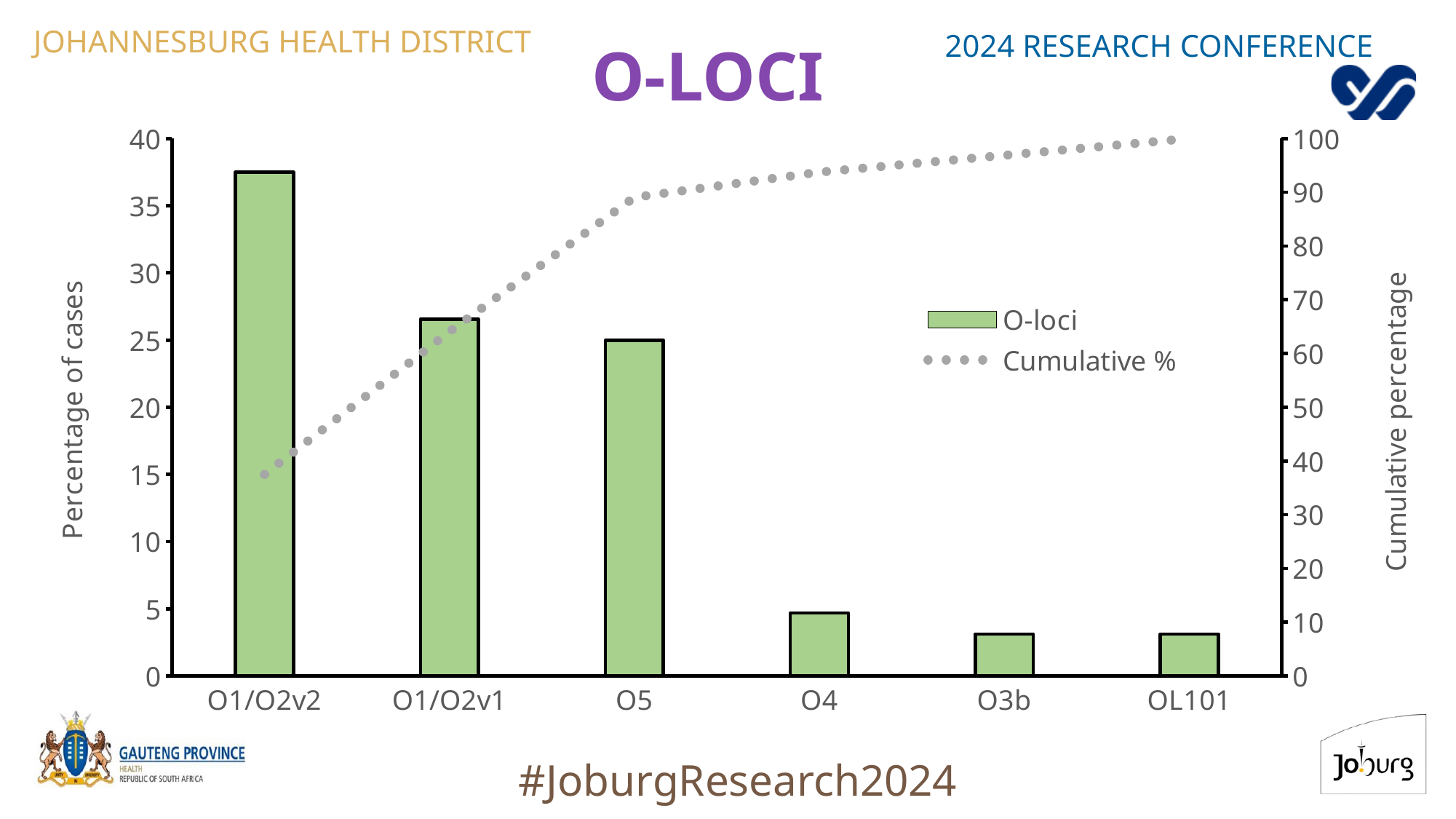
Which has a higher percentage of cases, O1/O2v1 or O5? O1/O2v1 Is the percentage of cases for O1/O2v2 greater or less than 35? greater What is the cumulative percentage at OL101? 100 How many categories are shown on the x axis? 6 Which category has the highest percentage of cases? O1/O2v2 Do the O-loci bar values rise or fall from left to right along the x axis? fall What is the label of the left vertical axis? Percentage of cases What is the title of the chart? O-LOCI Is the cumulative percentage at O5 greater or less than 80? greater What kind of chart is used to show the O-loci series? bar chart How many series does the legend list? 2